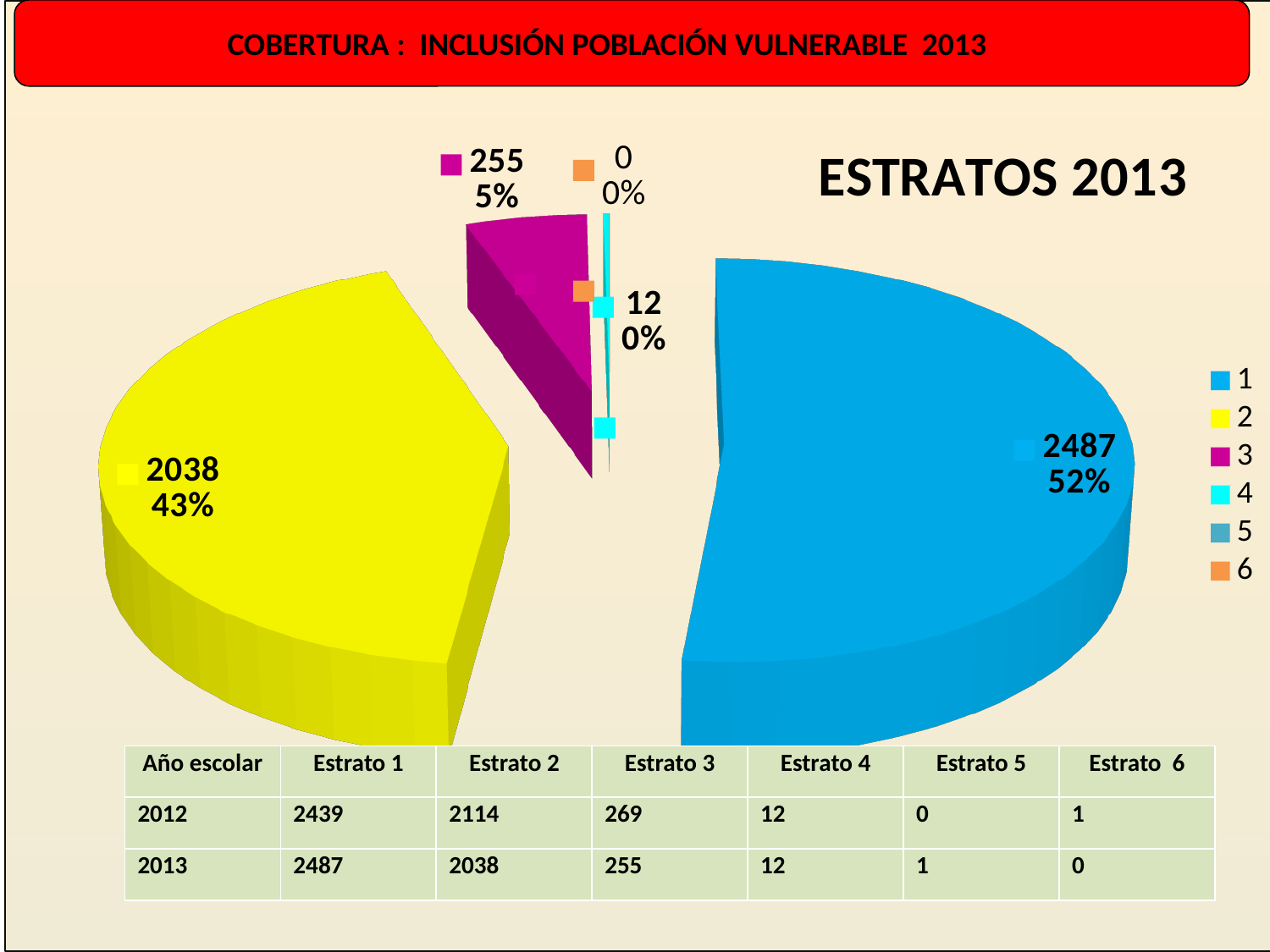
What is the title of the chart? ESTRATOS 2013 What value is shown for estrato 2 in the pie chart? 2038 What percentage share does estrato 3 have in the pie chart? 5% Which colour represents estrato 2 in the pie chart? yellow How many entries does the chart legend list? 6 What value is shown for estrato 3 in the pie chart? 255 What kind of chart is shown on the slide? pie chart Which estrato has the largest slice in the pie chart? 1 What value is shown for estrato 1 in the pie chart? 2487 What percentage share does estrato 1 have in the pie chart? 52% What is the difference between the values for estrato 1 and estrato 2 in the pie chart? 449 What percentage share does estrato 2 have in the pie chart? 43%